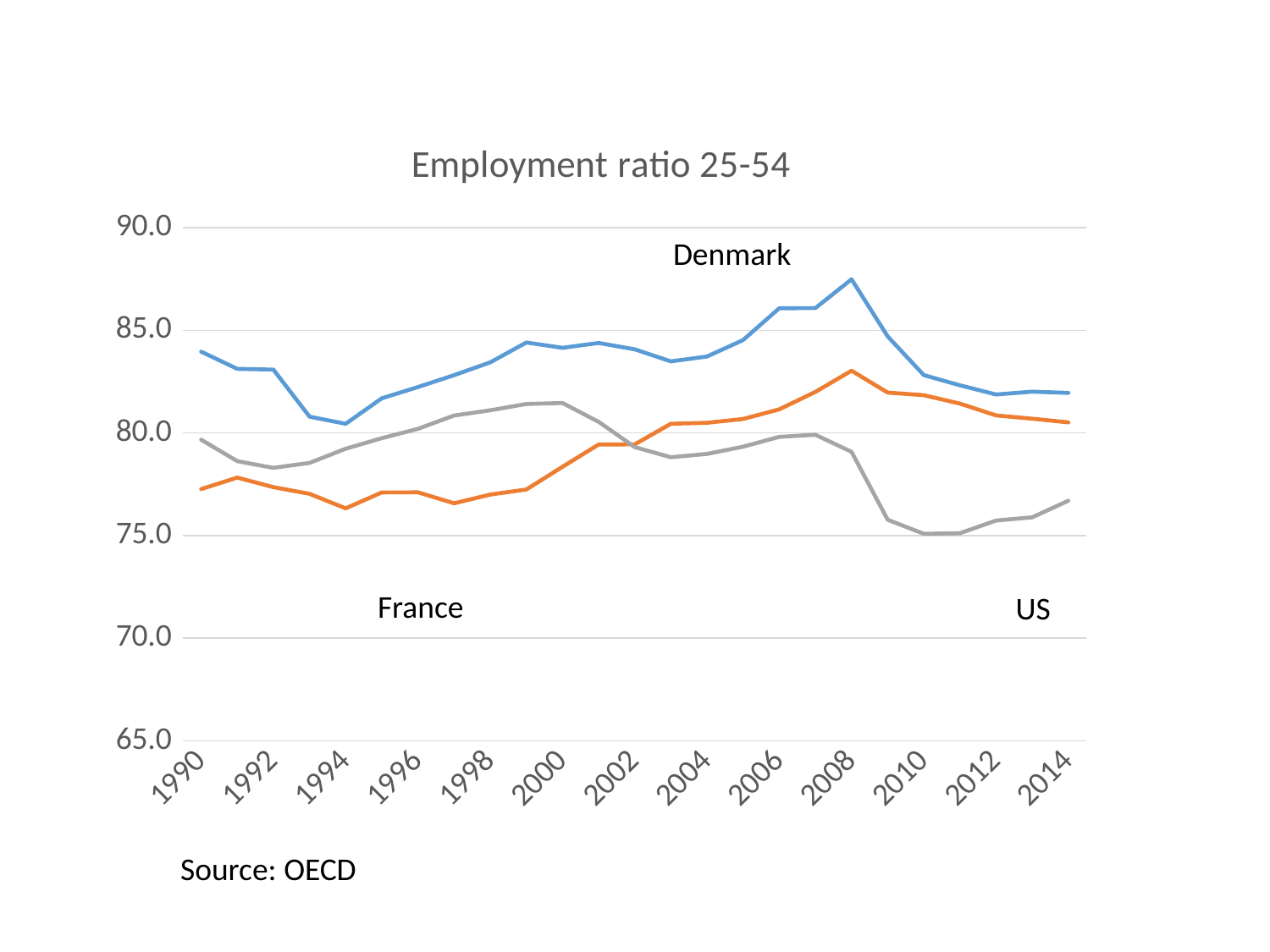
Does the France line rise or fall between 2004 and 2008? rise How many countries (series) are plotted on the chart? 3 Is the value for Denmark in 2008 greater or less than 85.0? greater Which country has the highest employment ratio in 2014? Denmark What kind of chart is shown on the slide? line chart Does the US line rise or fall between 2008 and 2010? fall What is the title of the chart? Employment ratio 25-54 In 2014, which is larger: the value for France or the value for the US? France In 1990, which is larger: the value for France or the value for the US? US Which country has the lowest employment ratio in 2014? US Is the value for the US in 2014 greater or less than 80.0? less Which country has the lowest employment ratio in 1990? France